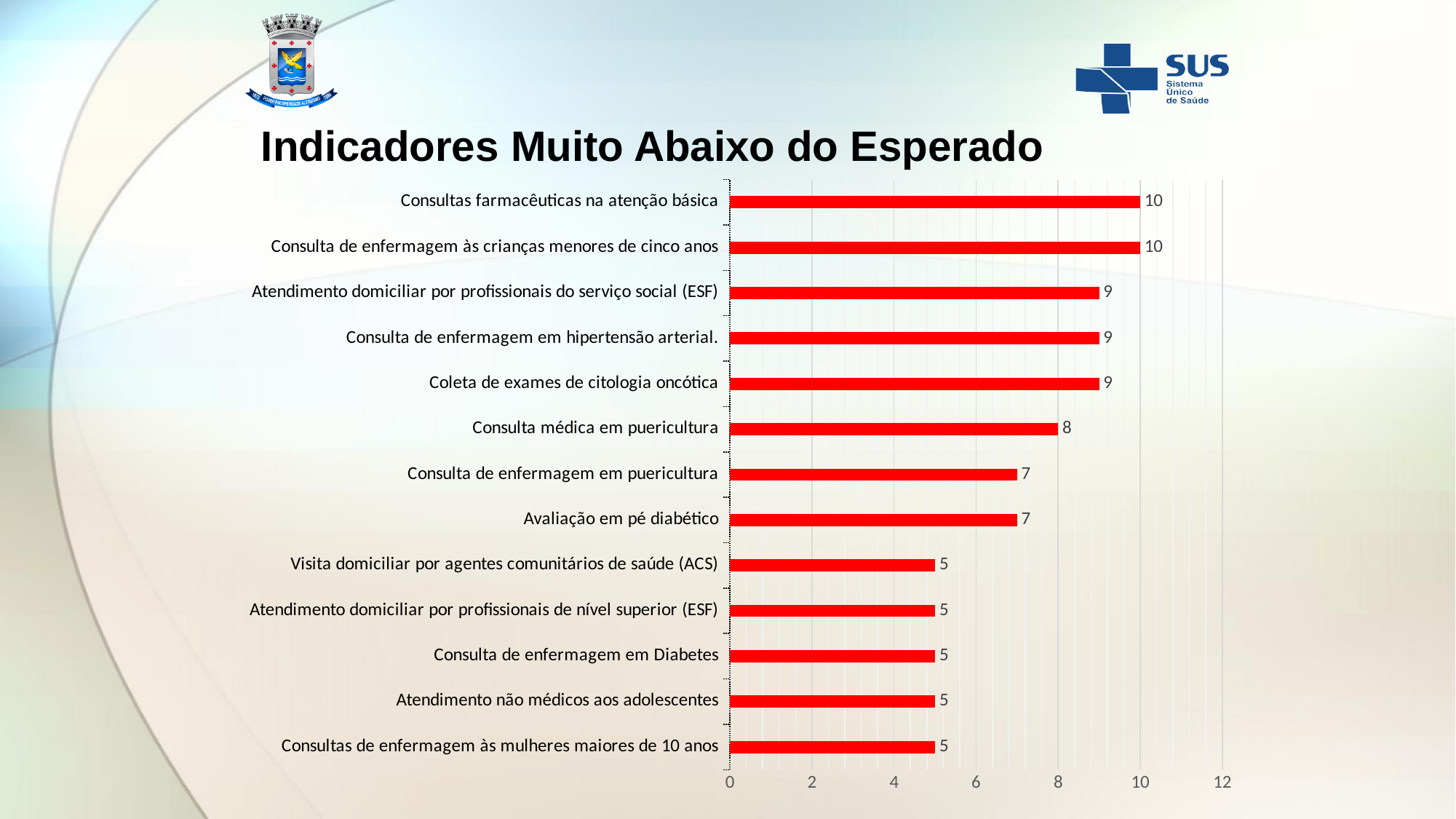
What is the value for "Consulta de enfermagem em Diabetes"? 5 What is the value for "Avaliação em pé diabético"? 7 What is the difference between the values for "Consultas farmacêuticas na atenção básica" and "Consultas de enfermagem às mulheres maiores de 10 anos"? 5 Which is larger, the value for "Consulta médica em puericultura" or the value for "Consulta de enfermagem em puericultura"? Consulta médica em puericultura Is the value for "Atendimento domiciliar por profissionais do serviço social (ESF)" greater or less than 6? greater What kind of chart is shown on the slide? Bar chart What colour are the bars in the chart? Red How many categories are shown in the chart? 13 What is the title of the slide? Indicadores Muito Abaixo do Esperado What is the value for "Consulta médica em puericultura"? 8 What is the value for "Coleta de exames de citologia oncótica"? 9 What is the value for "Consultas farmacêuticas na atenção básica"? 10